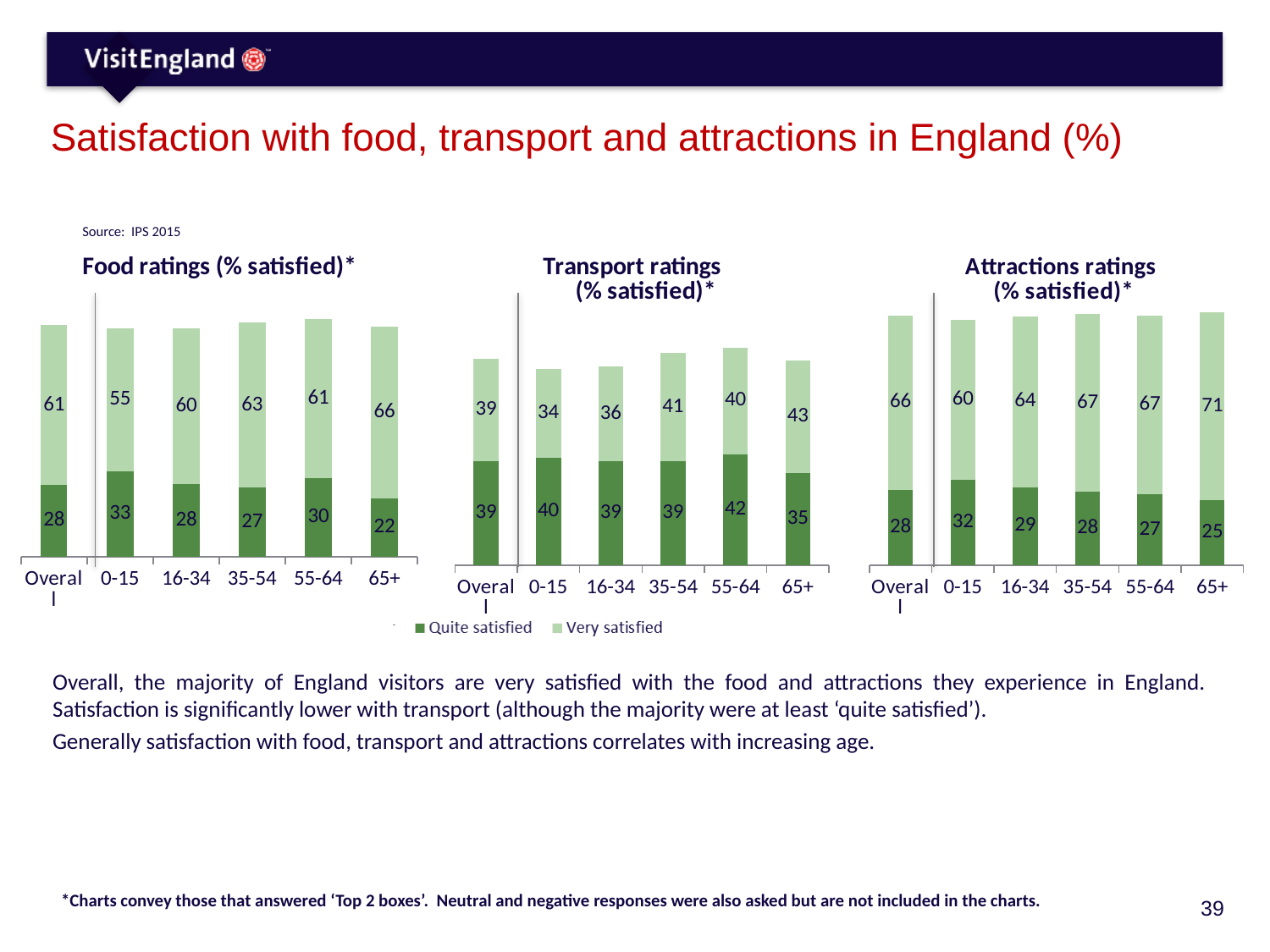
In the Food ratings chart, which category has the lowest 'Quite satisfied' value? 65+ How many series does the legend list? 2 In the Food ratings chart, what is the difference between the 'Very satisfied' values for 65+ and 0-15? 11 How many categories are shown on the x axis of the Transport ratings chart? 6 In the Transport ratings chart, what is the total of the stacked bar for the 65+ age group? 78 In the Attractions ratings chart, is the 'Very satisfied' value for 0-15 larger or smaller than that for 16-34? smaller In the Transport ratings chart, what is the 'Quite satisfied' value for the 55-64 age group? 42 What type of chart is the Food ratings chart? Stacked bar chart In the Attractions ratings chart, which age group has the highest 'Very satisfied' value? 65+ What are the two series named in the legend? Quite satisfied and Very satisfied In the Food ratings chart, what percentage of the 65+ age group is very satisfied? 66 In the Attractions ratings chart, what is the 'Very satisfied' value for the Overall category? 66